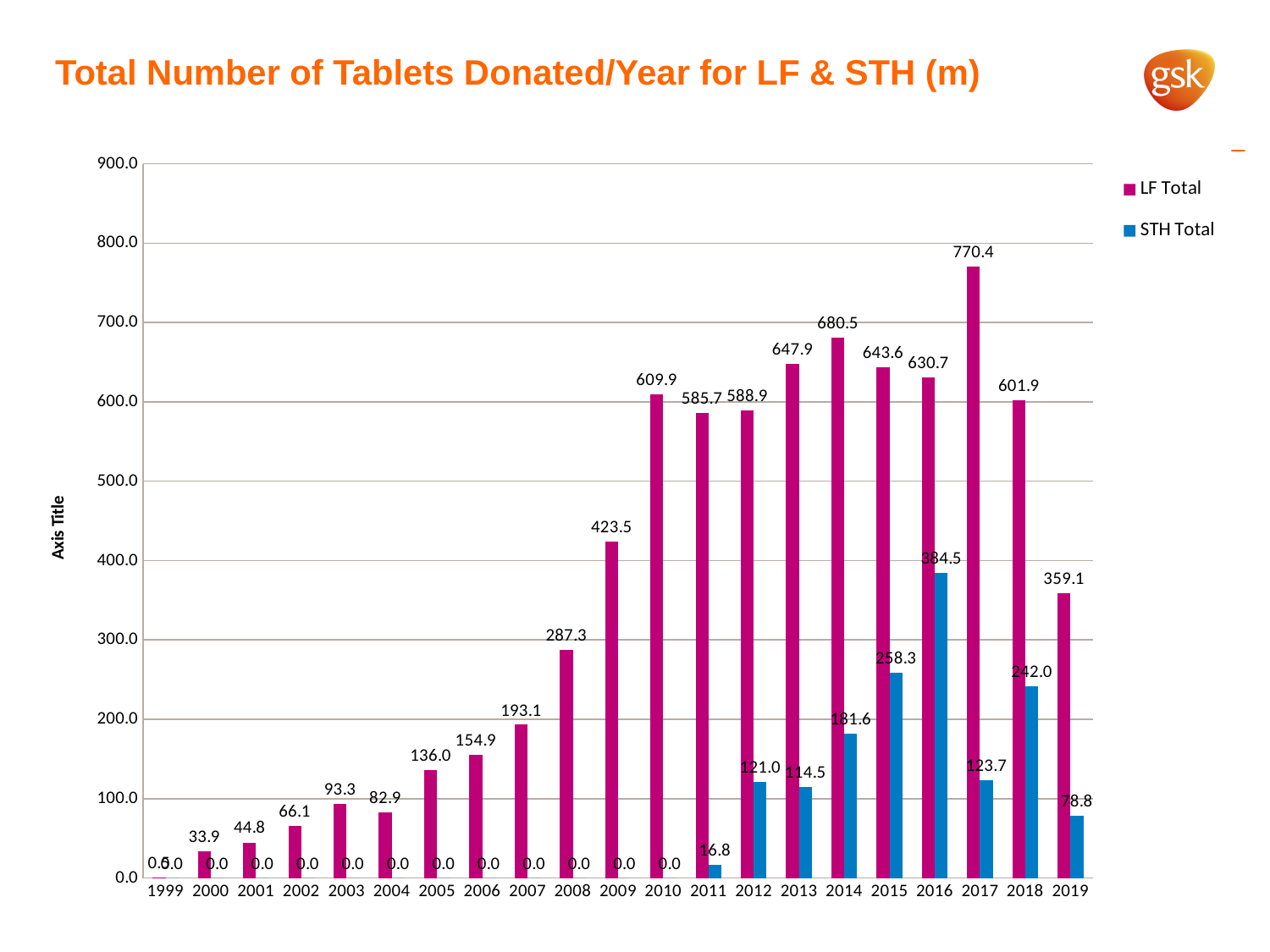
In which year is the STH Total highest? 2016 What is the STH Total value for 2011? 16.8 What is the difference between the LF Total for 2017 and the LF Total for 2018? 168.5 What is the difference between the STH Total for 2018 and the STH Total for 2017? 118.3 Is the LF Total for 2009 greater or less than 400? greater How many years are shown on the x axis? 21 What is the LF Total value for 2017? 770.4 In which year is the LF Total highest? 2017 Which year has the larger LF Total, 2013 or 2014? 2014 What kind of chart is shown on the slide? bar chart What is the STH Total value for 2016? 384.5 How many series does the legend list? 2